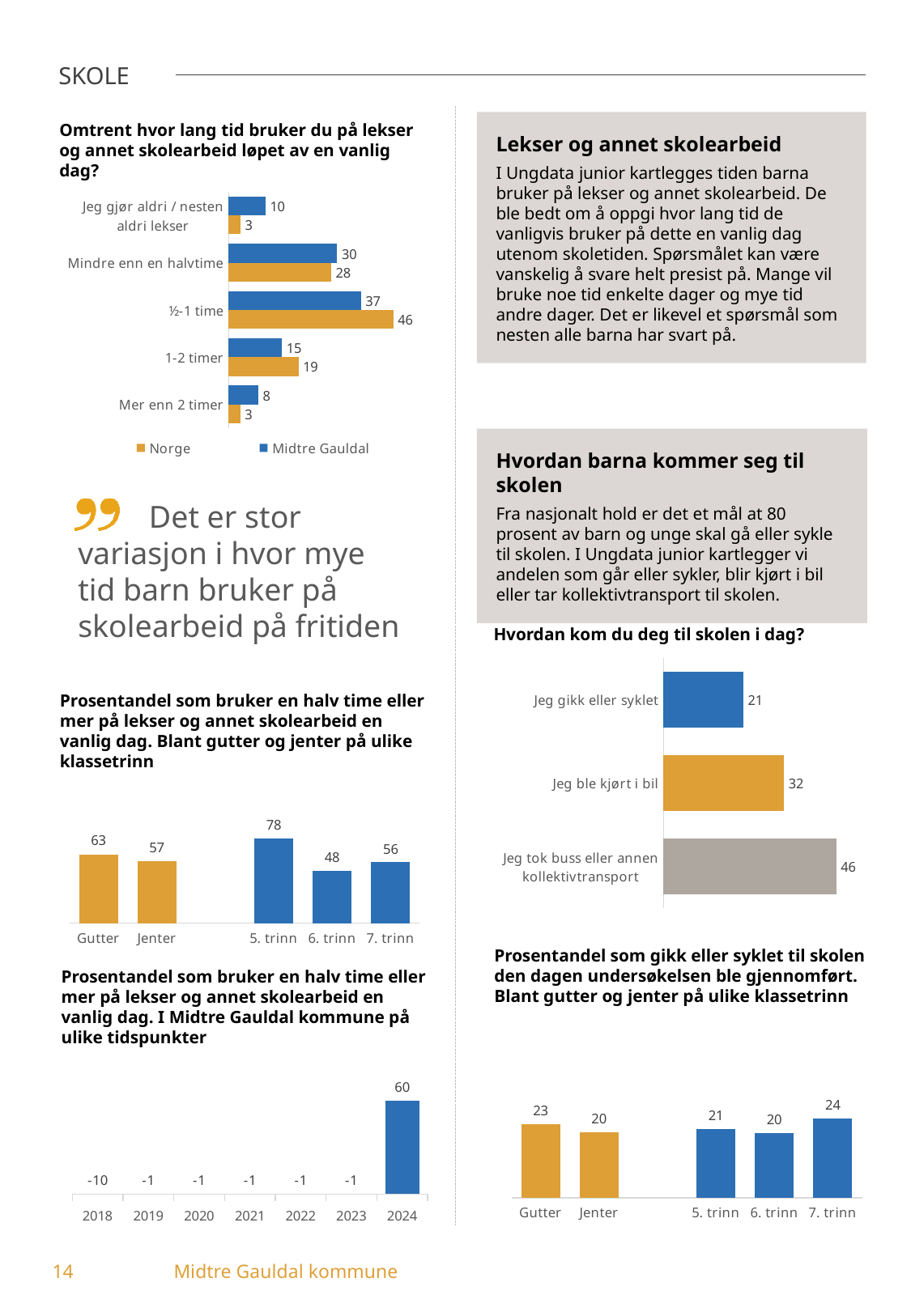
In the chart 'Prosentandel som gikk eller syklet til skolen den dagen undersøkelsen ble gjennomført. Blant gutter og jenter på ulike klassetrinn', which is larger, Gutter or Jenter? Gutter In the chart 'Omtrent hvor lang tid bruker du på lekser og annet skolearbeid løpet av en vanlig dag?', what is the difference between Norge and Midtre Gauldal for '½-1 time'? 9 In the chart 'Omtrent hvor lang tid bruker du på lekser og annet skolearbeid løpet av en vanlig dag?', which series is shown in orange? Norge What kind of chart is 'Hvordan kom du deg til skolen i dag?'? Bar chart In the chart 'Prosentandel som bruker en halv time eller mer på lekser og annet skolearbeid en vanlig dag. Blant gutter og jenter på ulike klassetrinn', what is the value for Jenter? 57 In the chart 'Hvordan kom du deg til skolen i dag?', what is the value for 'Jeg ble kjørt i bil'? 32 In the chart 'Omtrent hvor lang tid bruker du på lekser og annet skolearbeid løpet av en vanlig dag?', what is the value for Norge for '1-2 timer'? 19 How many series does the legend list in the chart 'Omtrent hvor lang tid bruker du på lekser og annet skolearbeid løpet av en vanlig dag?'? 2 In the chart 'Omtrent hvor lang tid bruker du på lekser og annet skolearbeid løpet av en vanlig dag?', what is the value for Midtre Gauldal for '½-1 time'? 37 In the chart 'Hvordan kom du deg til skolen i dag?', which category has the lowest value? Jeg gikk eller syklet In the chart 'Prosentandel som bruker en halv time eller mer på lekser og annet skolearbeid en vanlig dag. Blant gutter og jenter på ulike klassetrinn', which category has the highest value? 5. trinn In the chart 'Prosentandel som bruker en halv time eller mer på lekser og annet skolearbeid en vanlig dag. I Midtre Gauldal kommune på ulike tidspunkter', what is the value for 2024? 60